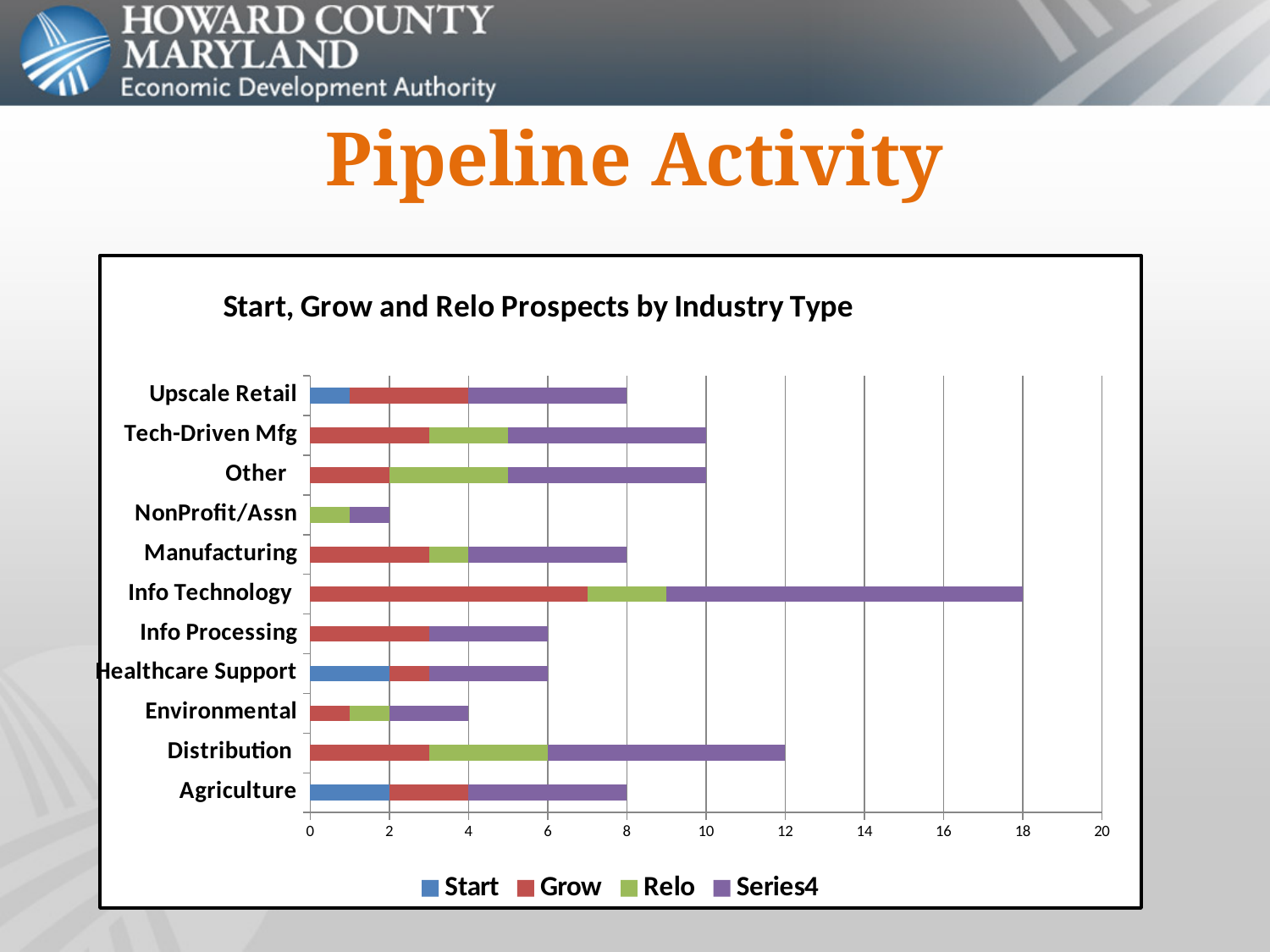
What is the Start value for Agriculture? 2 What kind of chart is shown on the slide? bar chart What is the difference between the total bar for Info Technology and the total bar for Distribution? 6 What is the title of the chart? Start, Grow and Relo Prospects by Industry Type What is the total of the stacked bar for Distribution? 12 How many industry categories are shown on the chart? 11 Which has the larger total bar, Distribution or Tech-Driven Mfg? Distribution How many series does the legend list? 4 Which industry has the longest total bar? Info Technology Which industry has the shortest total bar? NonProfit/Assn Is the total bar for Environmental greater or less than 6? less What is the total of the stacked bar for Info Technology? 18